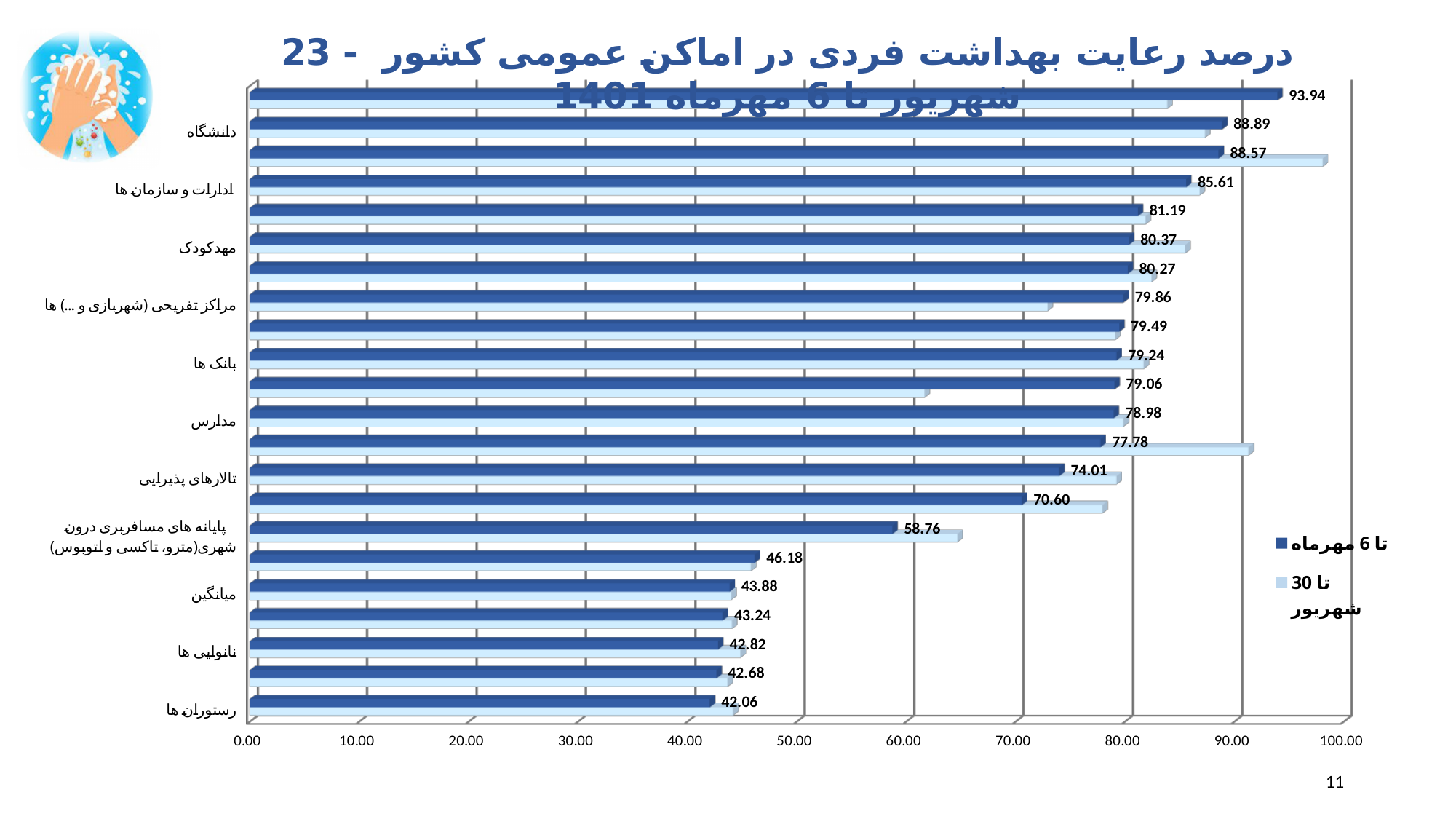
What is the value of the 'تا 6 مهرماه' series for دانشگاه? 88.89 What is the maximum value shown on the horizontal axis? 100.00 What is the value of the 'تا 6 مهرماه' series for میانگین? 43.88 What is the value of the 'تا 6 مهرماه' series for رستوران ها? 42.06 Which labelled category has the lowest 'تا 6 مهرماه' value? رستوران ها How many series does the legend list? 2 Which has a larger 'تا 6 مهرماه' value, ادارات و سازمان ها or مهدکودک? ادارات و سازمان ها What is the highest value printed for the 'تا 6 مهرماه' series? 93.94 What type of chart is shown on the slide? Bar chart What is the difference between the 'تا 6 مهرماه' values for دانشگاه and رستوران ها? 46.83 Is the 'تا 30 شهریور' value for the bar whose 'تا 6 مهرماه' value is 88.57 greater or less than 90.00? greater Is the 'تا 30 شهریور' value for the bar whose 'تا 6 مهرماه' value is 79.06 greater or less than 70.00? less